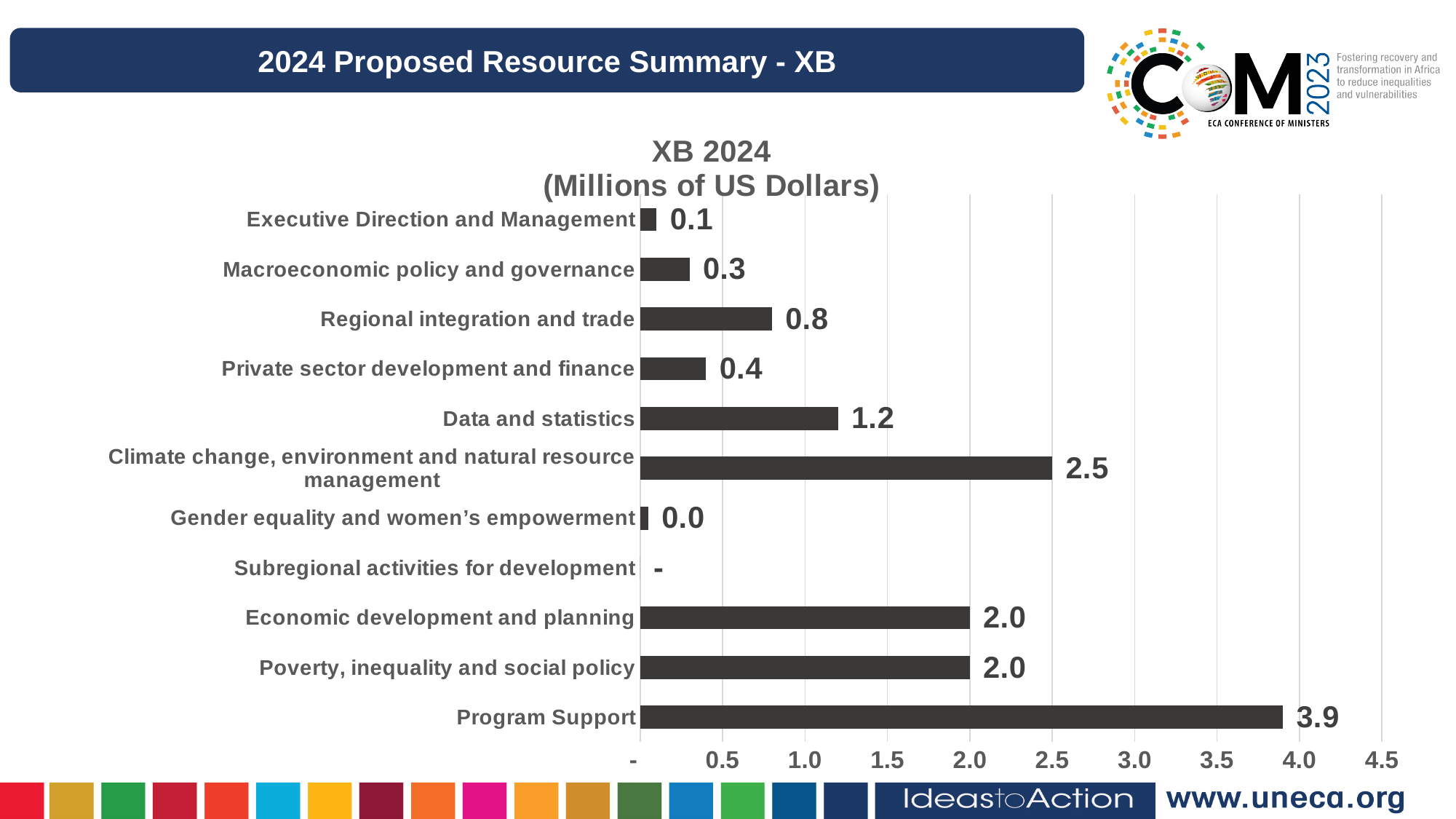
Which category has the highest value? Program Support What is the difference between Program Support and Climate change, environment and natural resource management? 1.4 What is the title of the chart? XB 2024 (Millions of US Dollars) How many categories are shown on the chart? 11 Is the value for Program Support greater or less than 3.5? greater What is the value for Data and statistics? 1.2 What kind of chart is shown? bar chart Which is larger, Regional integration and trade or Macroeconomic policy and governance? Regional integration and trade What is the difference between Data and statistics and Private sector development and finance? 0.8 What is the value for Regional integration and trade? 0.8 What is the value for Program Support? 3.9 What is the value for Climate change, environment and natural resource management? 2.5